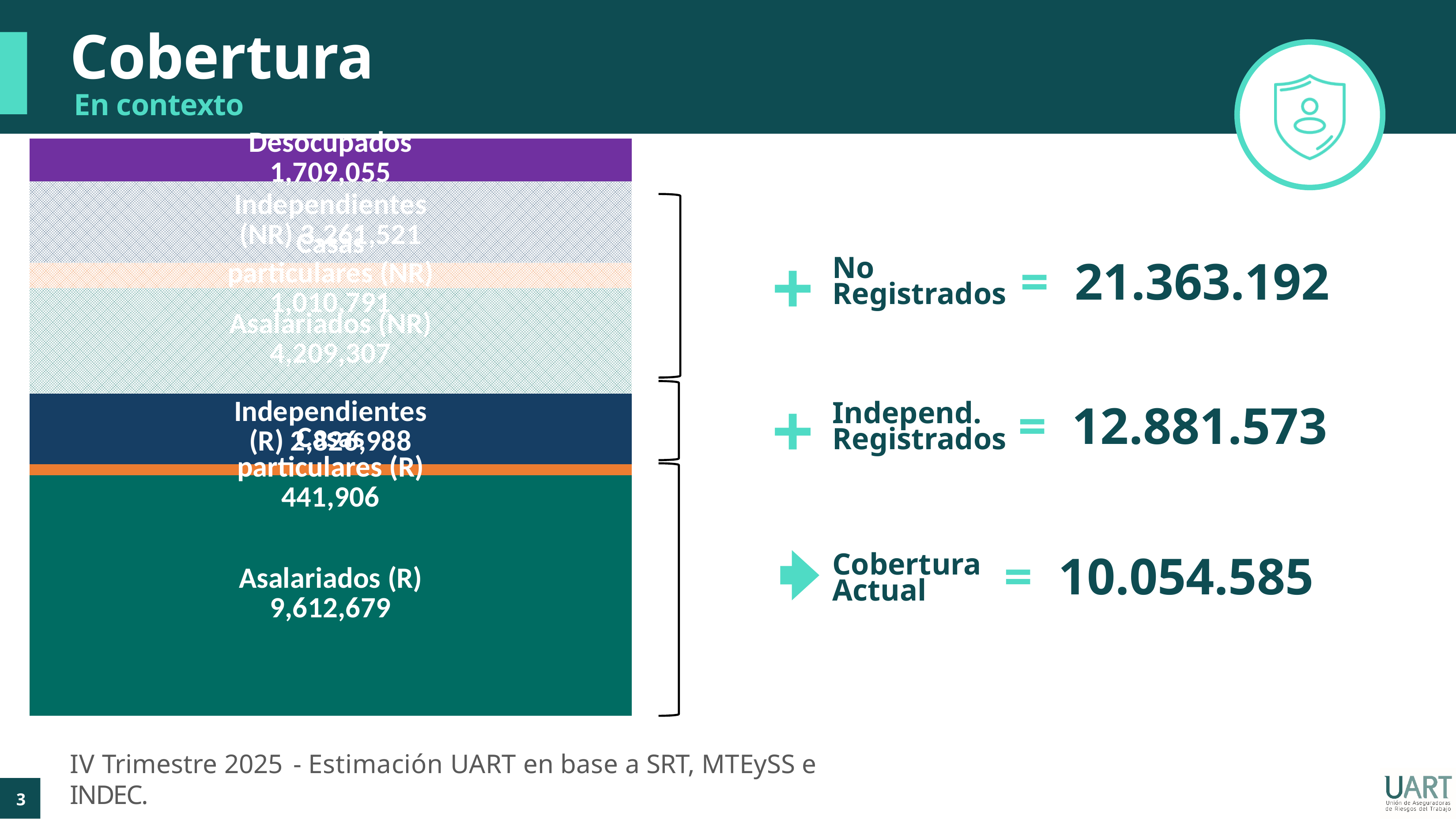
What value is shown for the Casas particulares (NR) segment? 1,010,791 What kind of chart is shown on the slide? Stacked bar chart Which is larger, Asalariados (R) or Asalariados (NR)? Asalariados (R) Which segment of the stacked bar is the smallest? Casas particulares (R) What is the difference between Casas particulares (NR) and Casas particulares (R)? 568,885 What value is shown for the Asalariados (R) segment of the stacked bar? 9,612,679 What is the difference between Asalariados (R) and Asalariados (NR)? 5,403,372 How many segments make up the stacked bar? 7 Which segment of the stacked bar is the largest? Asalariados (R) What value is shown for the Casas particulares (R) segment? 441,906 What value is shown for the Desocupados segment at the top of the bar? 1,709,055 What value is shown for the Asalariados (NR) segment? 4,209,307